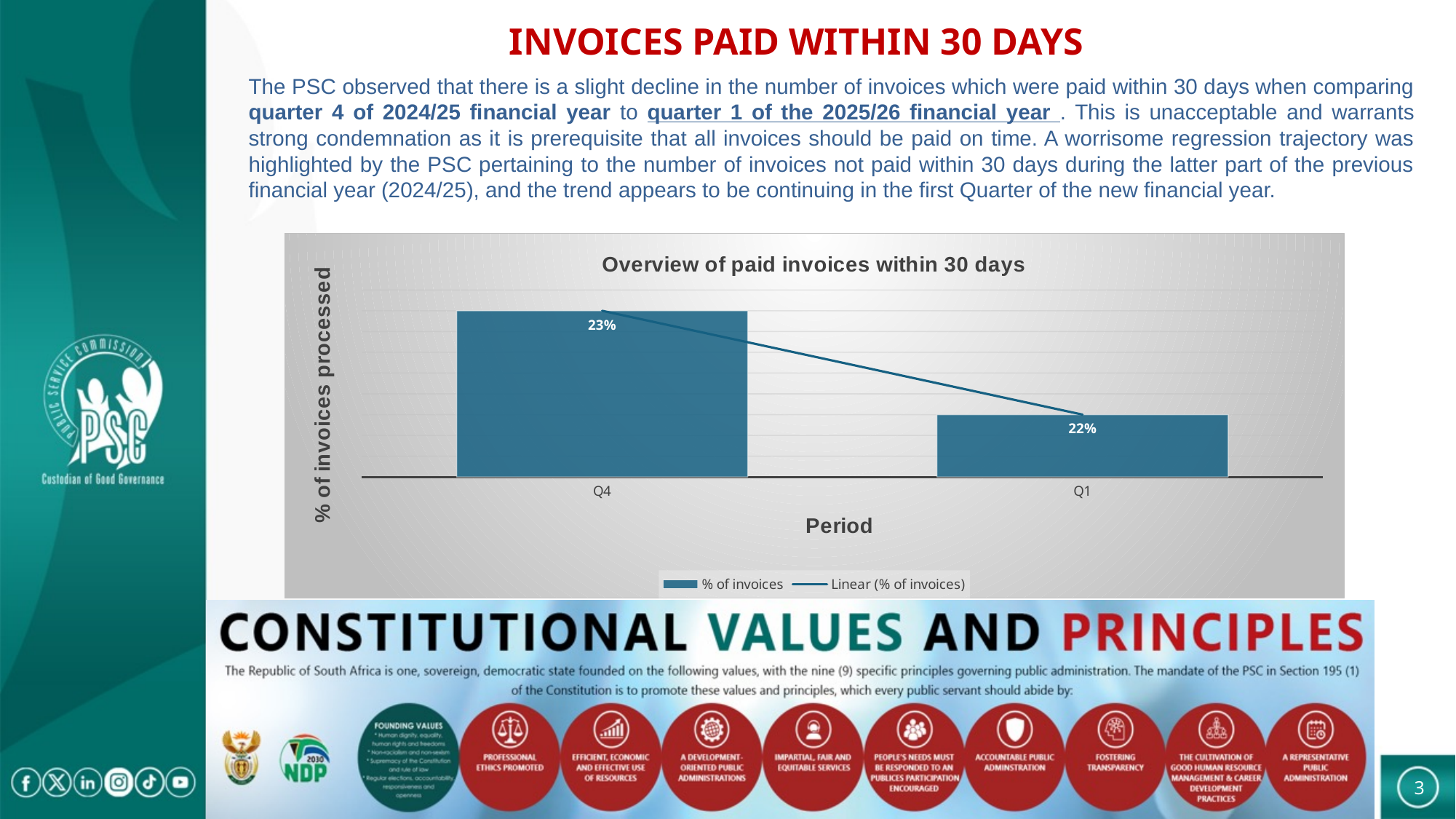
Do the values rise or fall from Q4 to Q1? Fall What kind of chart is shown on the slide? Bar chart What is the value for Q1 in the chart? 22% Which period has the highest percentage of invoices processed? Q4 What is the value for Q4 in the chart? 23% Which period has the lowest percentage of invoices processed? Q1 How many entries does the chart legend list? 2 What is the title of the chart? Overview of paid invoices within 30 days Which is larger, the value for Q4 or the value for Q1? Q4 What is the label of the x axis of the chart? Period What is the difference between the Q4 and Q1 values? 1% How many periods are shown on the x axis of the chart? 2